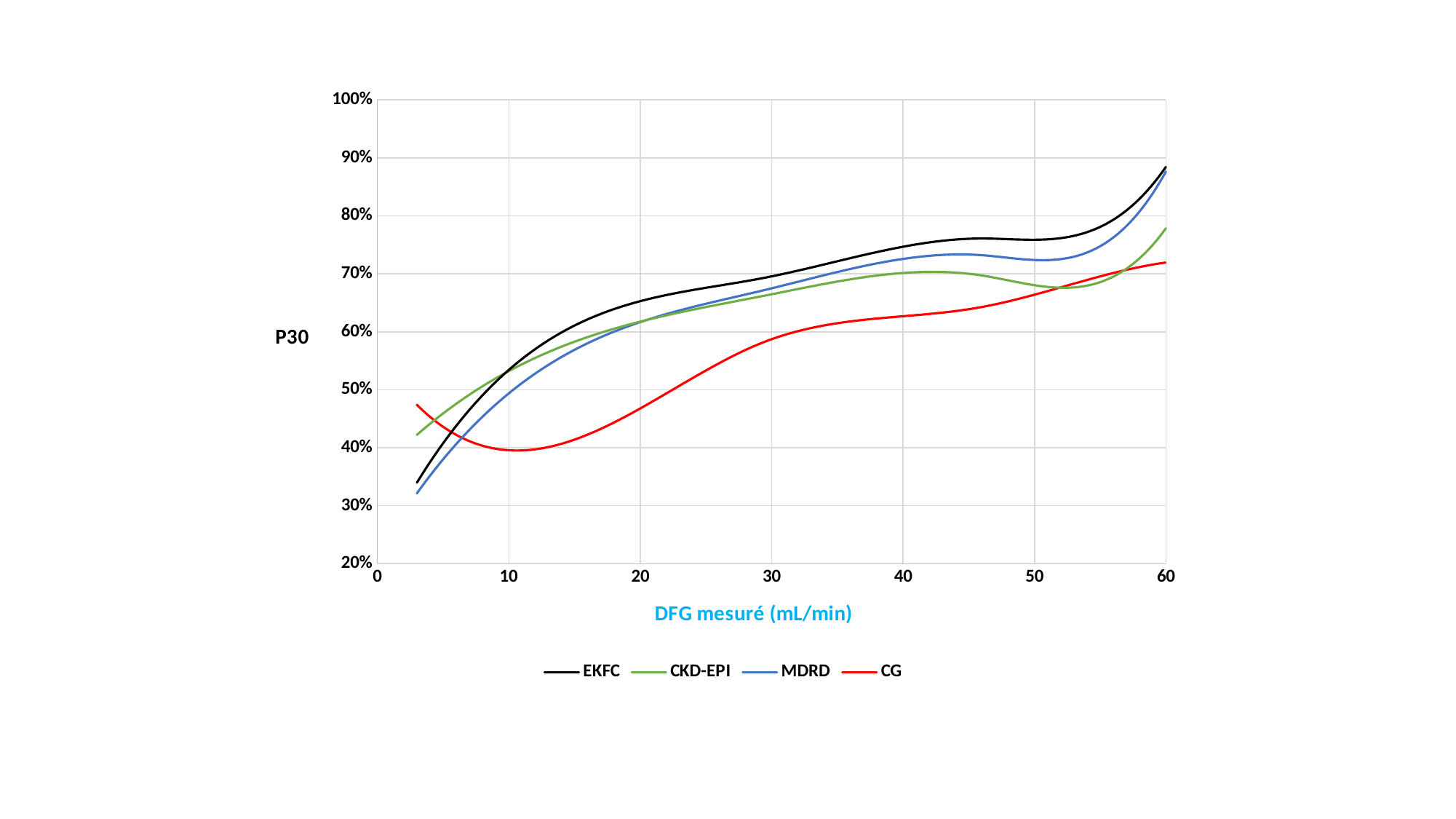
Is the value for CG at a measured DFG of 40 greater or less than 60%? greater What kind of chart is shown on the slide? line chart Is the value for EKFC at a measured DFG of 60 greater or less than 80%? greater Which colour is used for the CG line? red At a measured DFG of 30, which series has the lowest P30 value? CG How many series does the legend list? 4 Does the CG line rise or fall between a measured DFG of 20 and 60? rise Is the value for CG at a measured DFG of 20 greater or less than 50%? less At a measured DFG of 20, which is higher, EKFC or CG? EKFC What is the title of the x axis? DFG mesuré (mL/min) At a measured DFG of 30, which is higher, MDRD or CG? MDRD